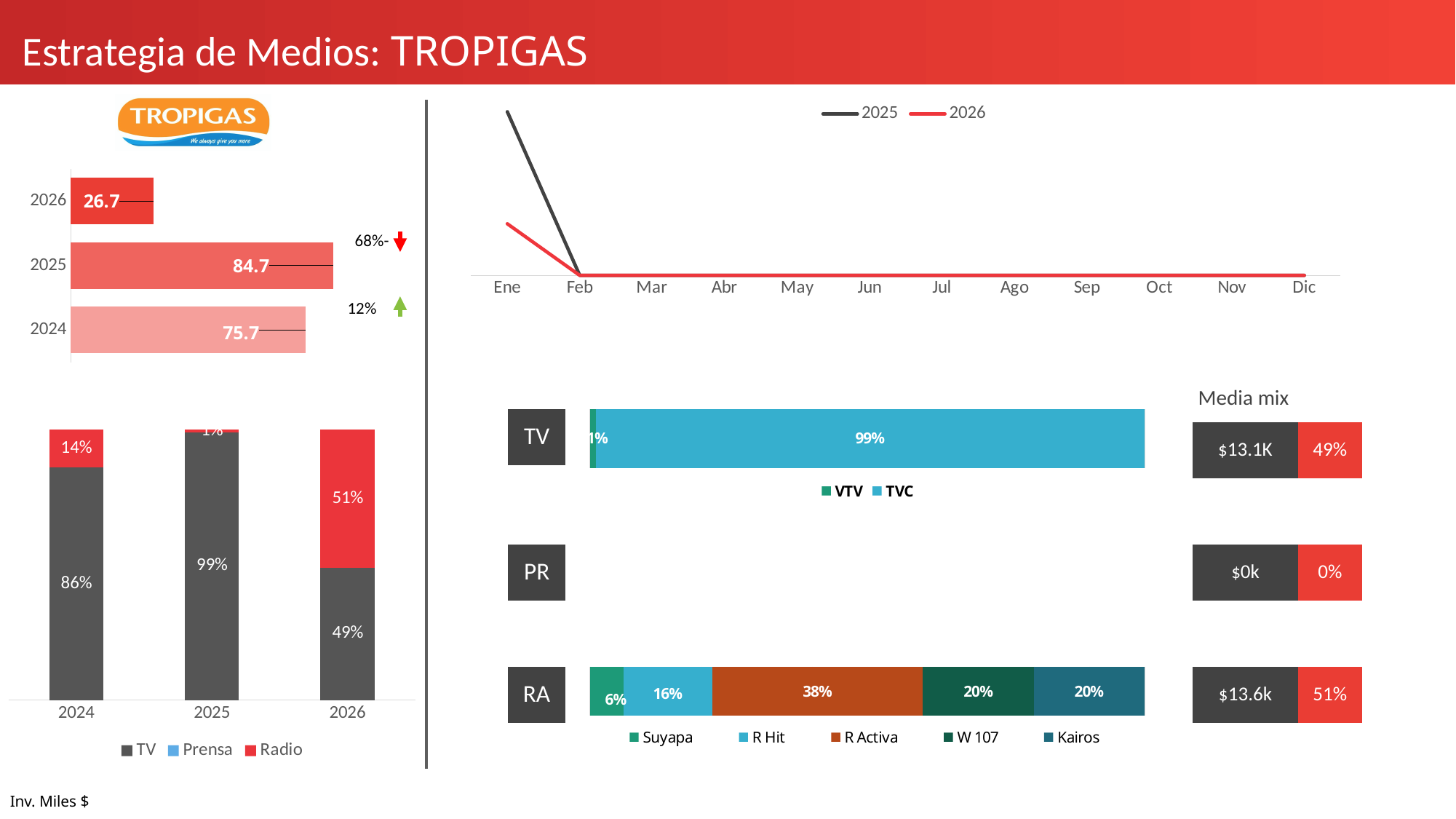
In the RA bar on the right, what is the share for R Activa? 38% In the RA bar on the right, which station has the largest share? R Activa In the top-left horizontal bar chart, what is the value for 2026? 26.7 In the bottom-left stacked bar chart, what is the TV share for 2026? 49% In the top-left horizontal bar chart, what is the difference between the 2025 and 2024 values? 9.0 In the top-left horizontal bar chart, what is the value for 2025? 84.7 In the top-right line chart, how many series does the legend list? 2 What kind of chart is the top-right chart with months Ene to Dic on the x axis? line chart In the top-left horizontal bar chart, which year has the highest value? 2025 In the bottom-left stacked bar chart, how many series does the legend list? 3 In the top-left horizontal bar chart, which year has the lowest value? 2026 In the bottom-left stacked bar chart, what is the Radio share for 2024? 14%